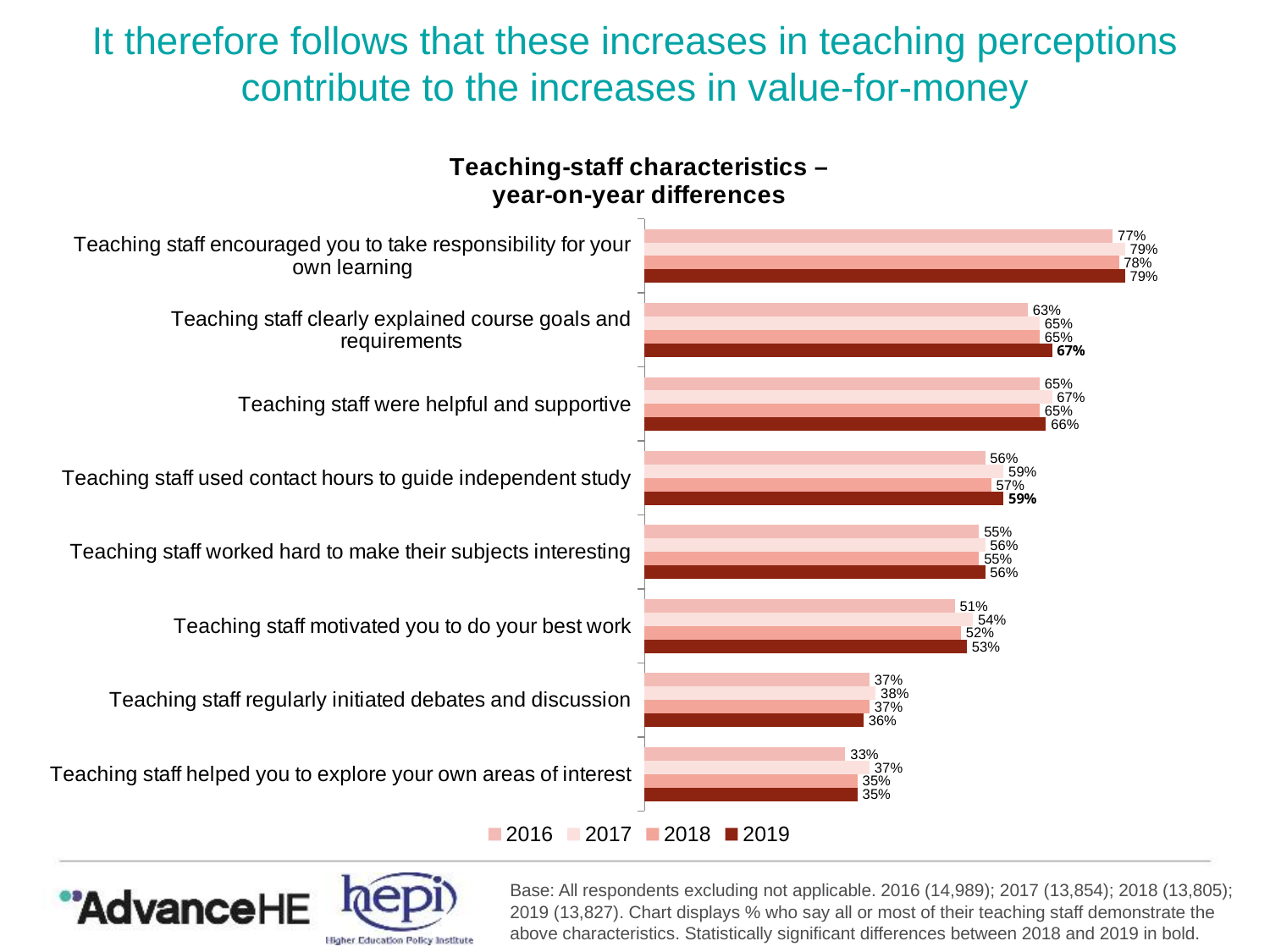
How many series does the legend list? 4 Which characteristic has the highest 2019 value? Teaching staff encouraged you to take responsibility for your own learning Which legend entry is shown in the darkest red colour? 2019 What is the 2017 value for 'Teaching staff motivated you to do your best work'? 54% What is the 2016 value for 'Teaching staff helped you to explore your own areas of interest'? 33% What kind of chart is shown on the slide? Bar chart What is the difference between the 2017 and 2016 values for 'Teaching staff helped you to explore your own areas of interest'? 4 percentage points Which characteristic has the lowest 2016 value? Teaching staff helped you to explore your own areas of interest How many teaching-staff characteristics are plotted on the chart? 8 What is the difference between the 2019 and 2016 values for 'Teaching staff clearly explained course goals and requirements'? 4 percentage points What is the 2019 value for 'Teaching staff clearly explained course goals and requirements'? 67% For 'Teaching staff regularly initiated debates and discussion', which is larger: the 2017 value or the 2019 value? 2017